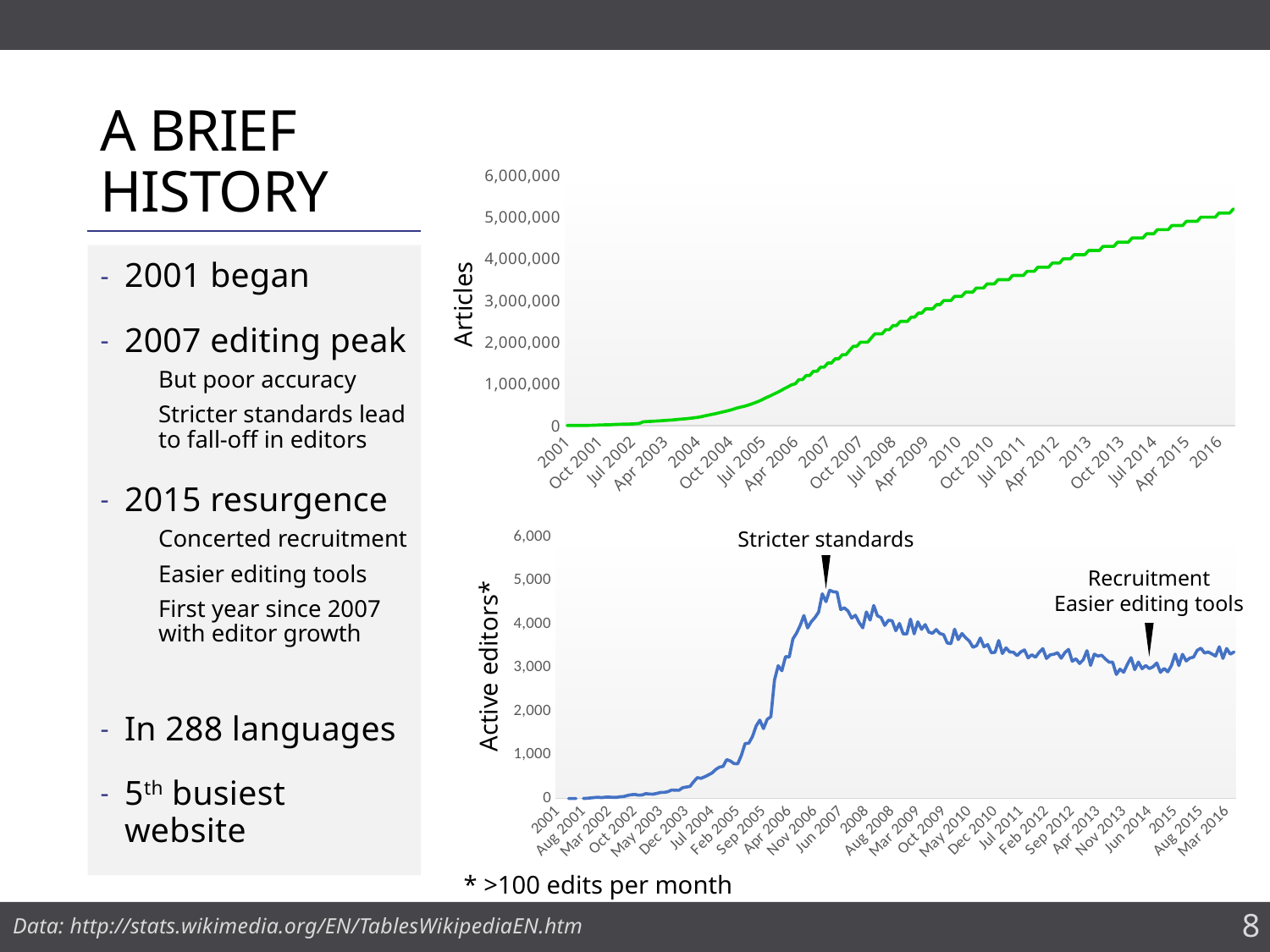
In the top 'Articles' chart, is the value for 2013 greater or less than 3,000,000? greater In the bottom 'Active editors*' chart, which is larger: the value in 2007 or the value in 2016? 2007 What kind of chart is the top chart labelled 'Articles'? line chart In the top 'Articles' chart, do the values rise or fall from 2001 to 2016? rise In the bottom 'Active editors*' chart, what annotation is placed at the 2007 peak? Stricter standards In the bottom 'Active editors*' chart, in which year does the line reach its highest point? 2007 What kind of chart is the bottom chart labelled 'Active editors*'? line chart In the top 'Articles' chart, is the value for 2016 greater or less than 4,000,000? greater In the top 'Articles' chart, is the value for 2004 greater or less than 1,000,000? less In the bottom 'Active editors*' chart, do the values rise or fall from Jun 2007 to Jun 2014? fall